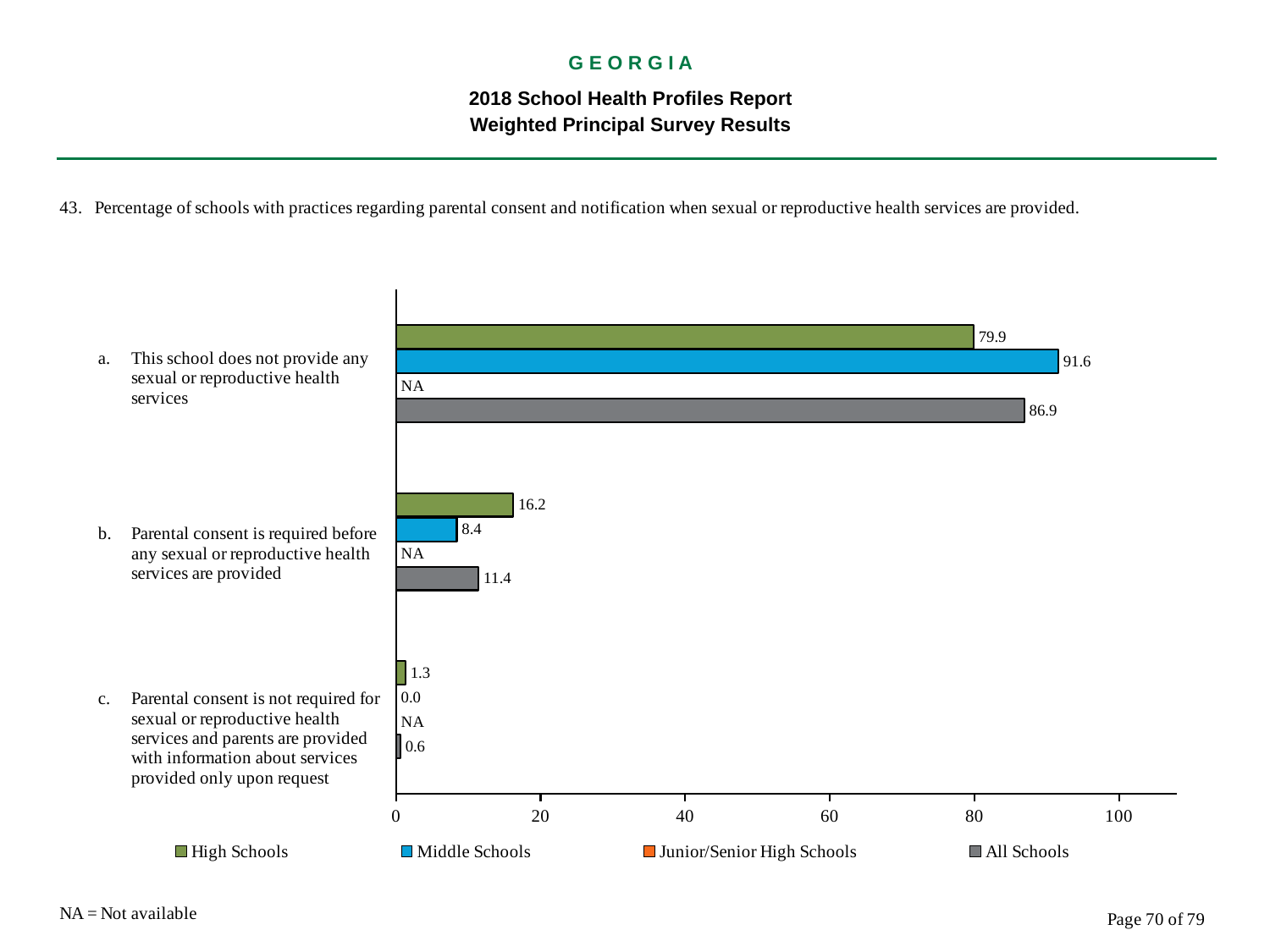
What is the difference between the Middle Schools and High Schools values for category a? 11.7 What is the value for High Schools for category a, 'This school does not provide any sexual or reproductive health services'? 79.9 Which school type has the highest value for category a, 'This school does not provide any sexual or reproductive health services'? Middle Schools What kind of chart is shown on the slide? bar chart What is the value for Middle Schools for category b, 'Parental consent is required before any sexual or reproductive health services are provided'? 8.4 What does NA stand for according to the note on the slide? Not available How many series does the legend list? 4 What is the value for All Schools for category c, 'Parental consent is not required for sexual or reproductive health services and parents are provided with information about services provided only upon request'? 0.6 Is the All Schools value for category a greater or less than 80? greater What value is shown for Junior/Senior High Schools in category a? NA Which is larger for category b: the High Schools value or the All Schools value? High Schools Which school type has the lowest value for category b, 'Parental consent is required before any sexual or reproductive health services are provided'? Middle Schools